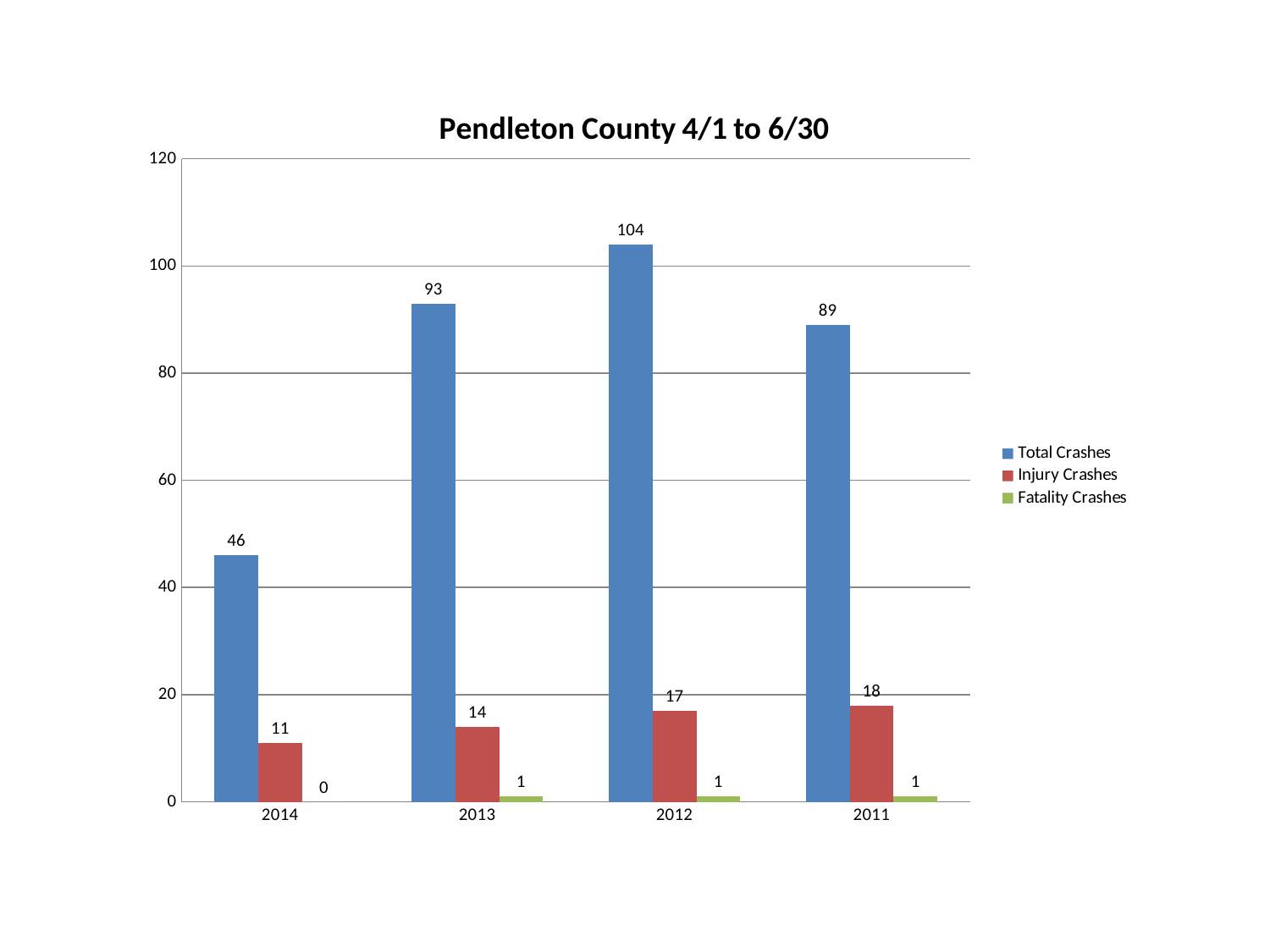
What is the value of Fatality Crashes for 2014? 0 Which year has the highest Total Crashes? 2012 Which is larger, Injury Crashes in 2012 or Injury Crashes in 2011? 2011 How many series does the legend list? 3 Which year has the lowest Injury Crashes? 2014 What is the value of Total Crashes for 2012? 104 Is the value of Total Crashes for 2014 greater or less than 40? greater What is the value of Injury Crashes for 2014? 11 What is the difference between Total Crashes in 2013 and 2011? 4 What kind of chart is shown on the slide? bar chart What is the title of the chart? Pendleton County 4/1 to 6/30 How many years are shown on the x axis? 4